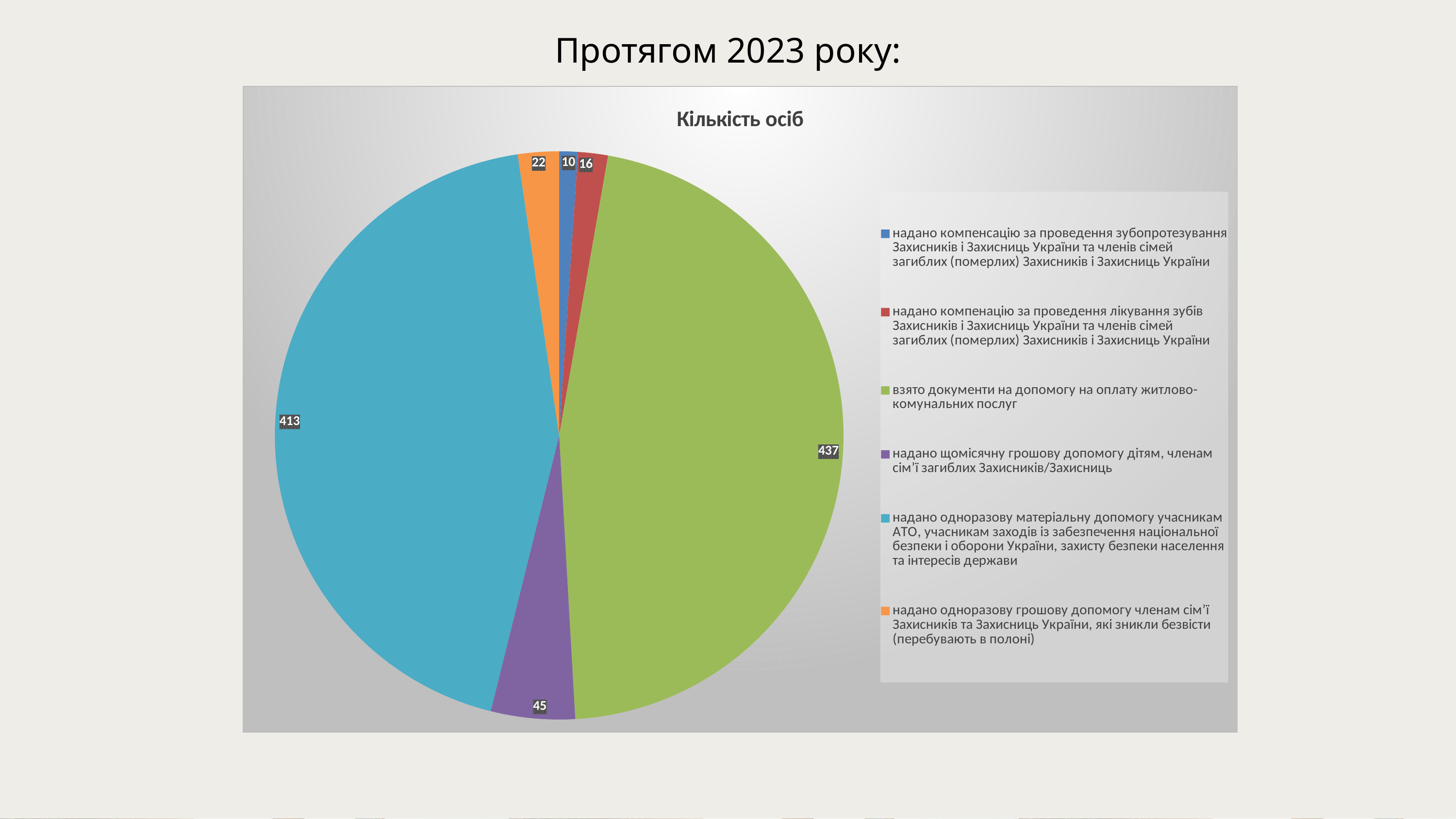
Which category has the largest slice? взято документи на допомогу на оплату житлово-комунальних послуг Which is larger: the value for 'надано компенацію за проведення лікування зубів...' or the value for 'надано одноразову грошову допомогу членам сім'ї Захисників та Захисниць України, які зникли безвісти (перебувають в полоні)'? надано одноразову грошову допомогу членам сім'ї Захисників та Захисниць України, які зникли безвісти (перебувають в полоні) What is the title of the chart? Кількість осіб What is the value for 'надано одноразову грошову допомогу членам сім'ї Захисників та Захисниць України, які зникли безвісти (перебувають в полоні)'? 22 What is the value for 'надано щомісячну грошову допомогу дітям, членам сім'ї загиблих Захисників/Захисниць'? 45 What is the value for 'надано одноразову матеріальну допомогу учасникам АТО, учасникам заходів із забезпечення національної безпеки і оборони України, захисту безпеки населення та інтересів держави'? 413 What type of chart is shown on the slide? pie chart Which category has the smallest slice? надано компенсацію за проведення зубопротезування Захисників і Захисниць України та членів сімей загиблих (померлих) Захисників і Захисниць України What is the value for 'взято документи на допомогу на оплату житлово-комунальних послуг'? 437 What is the value for 'надано компенсацію за проведення зубопротезування Захисників і Захисниць України та членів сімей загиблих (померлих) Захисників і Захисниць України'? 10 What is the difference between the value for 'взято документи на допомогу на оплату житлово-комунальних послуг' (437) and the value for 'надано одноразову матеріальну допомогу учасникам АТО...' (413)? 24 How many slices does the pie chart have? 6